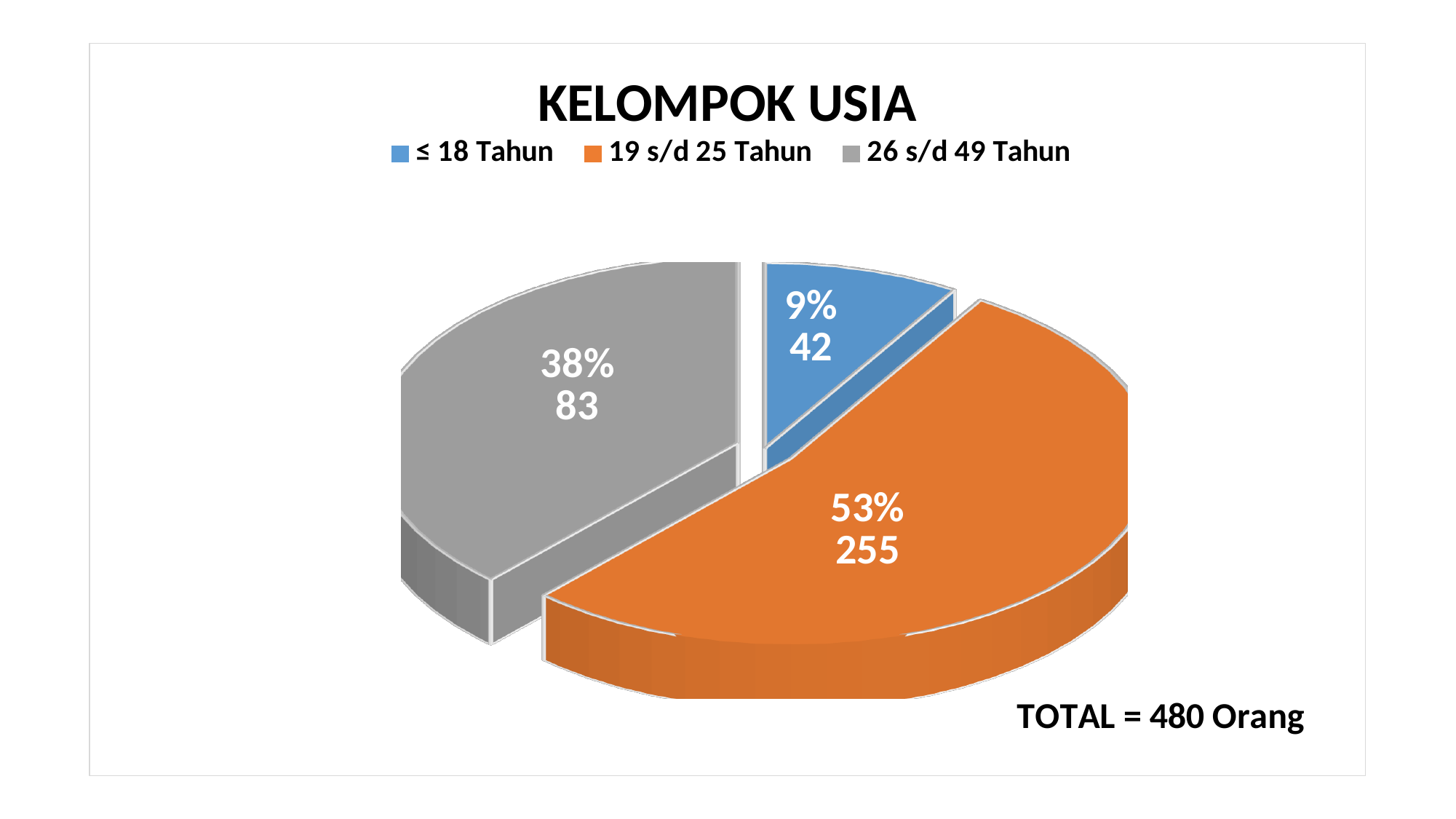
What percentage share does the ≤ 18 Tahun slice have? 9% How many slices does the pie chart have? 3 What is the title of the chart? KELOMPOK USIA What percentage share does the 26 s/d 49 Tahun slice have? 38% Which age group has the largest slice? 19 s/d 25 Tahun What count is shown for the ≤ 18 Tahun slice? 42 How many categories does the legend list? 3 What total number of people is stated on the slide? 480 Orang What percentage share does the 19 s/d 25 Tahun slice have? 53% What kind of chart is shown on the slide? Pie chart What count is shown for the 19 s/d 25 Tahun slice? 255 Which age group has the smallest slice? ≤ 18 Tahun